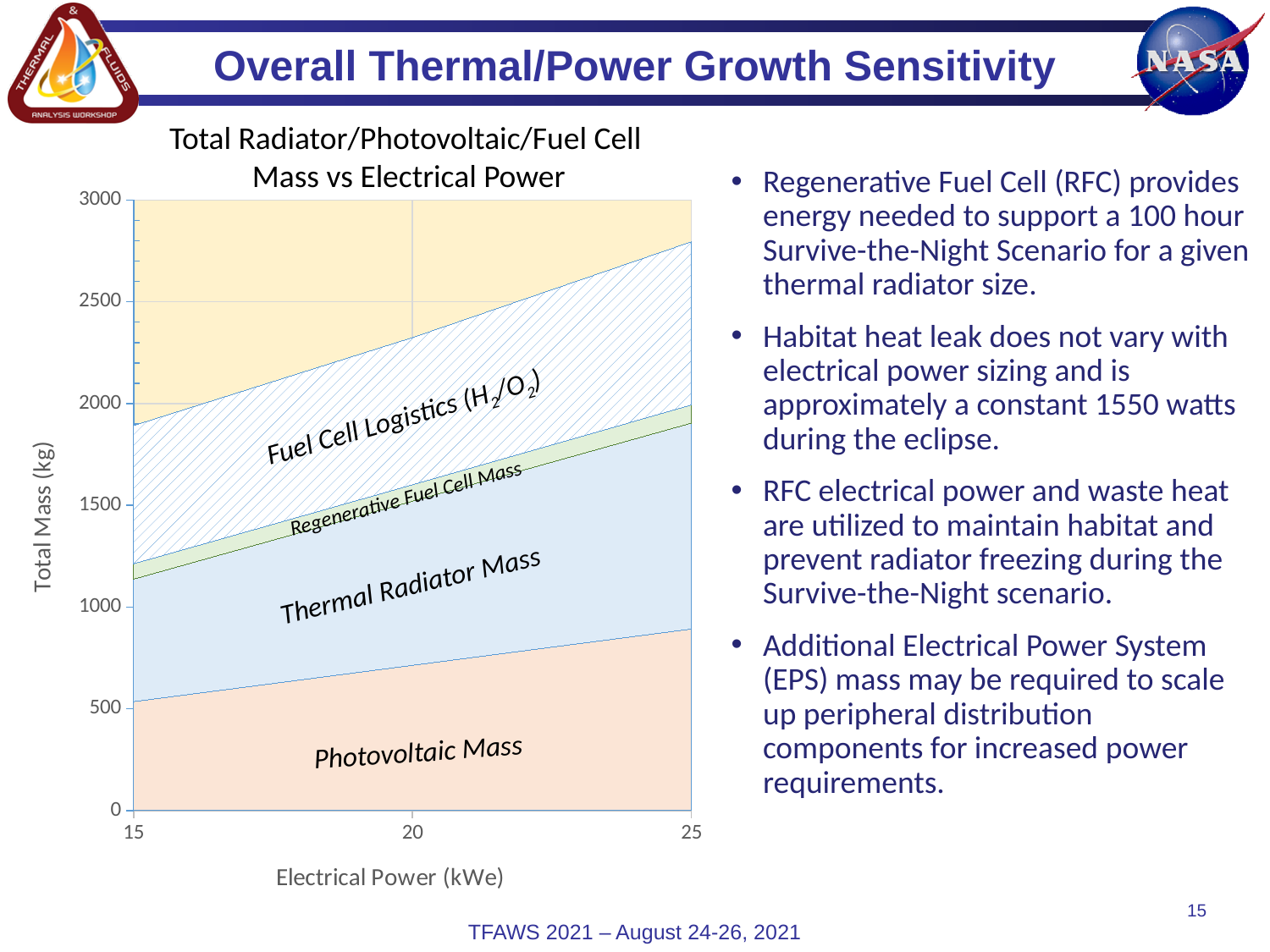
What kind of chart is shown on the slide? Stacked area chart What is the title of the chart? Total Radiator/Photovoltaic/Fuel Cell Mass vs Electrical Power Is the top of the Fuel Cell Logistics (H2/O2) layer at 25 kWe greater or less than 2500 kg? greater Is the top of the Thermal Radiator Mass layer at 15 kWe greater or less than 1000 kg? greater Is the top of the Fuel Cell Logistics (H2/O2) layer at 15 kWe greater or less than 2000 kg? less How many labeled mass components are shown in the stacked areas of the chart? 4 Does the total stacked mass rise or fall as electrical power increases from 15 to 25 kWe? Rise What is the label of the x axis of the chart? Electrical Power (kWe) Which labeled mass component forms the topmost layer of the stacked chart? Fuel Cell Logistics (H2/O2) Which mass component forms the bottom layer of the stacked chart? Photovoltaic Mass